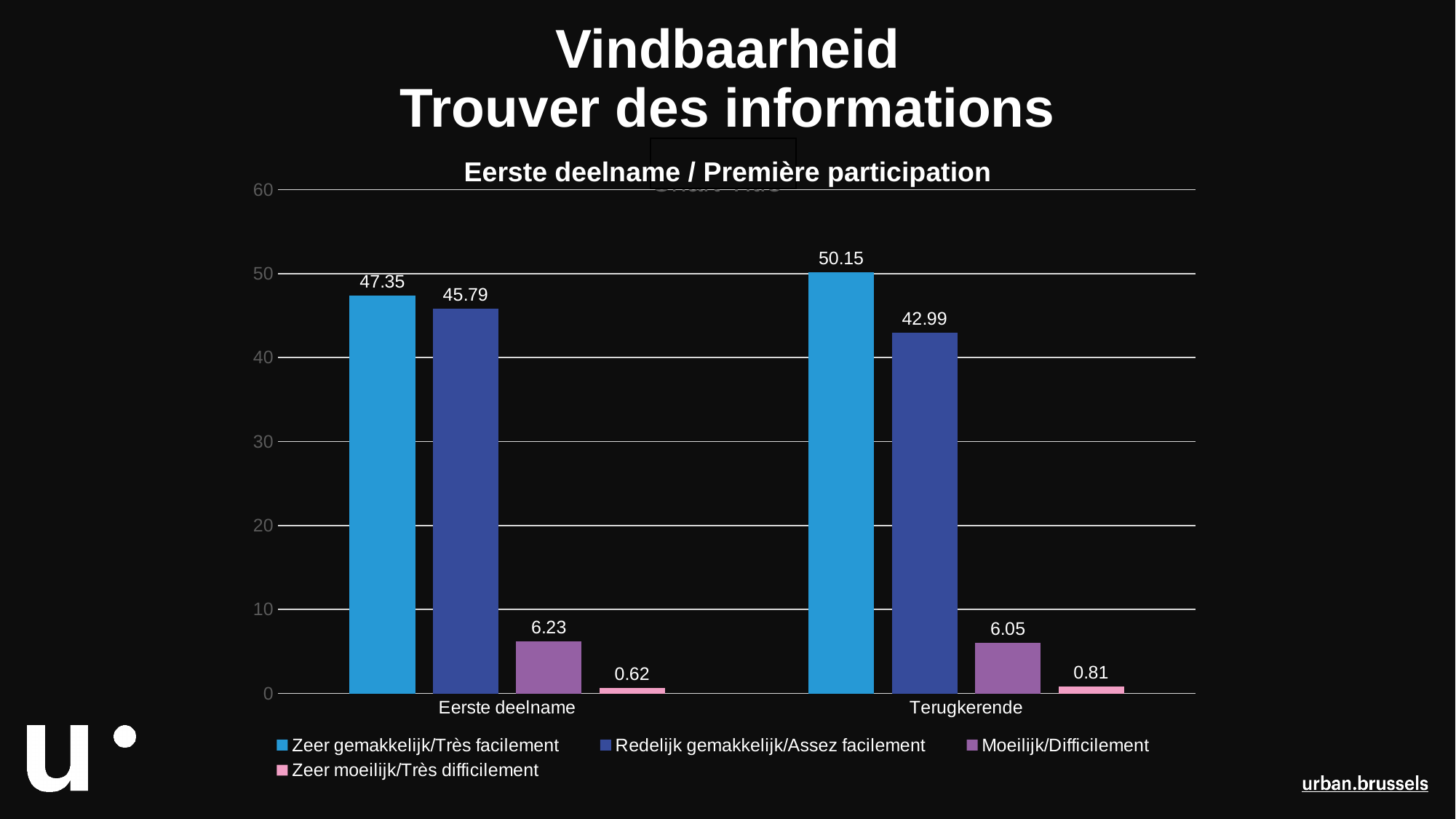
What is the value for Redelijk gemakkelijk/Assez facilement in the Terugkerende category? 42.99 What is the value for Moeilijk/Difficilement in the Eerste deelname category? 6.23 Which series has the highest value in the Terugkerende category? Zeer gemakkelijk/Très facilement What is the value for Zeer moeilijk/Très difficilement in the Terugkerende category? 0.81 What is the value for Zeer gemakkelijk/Très facilement in the Eerste deelname category? 47.35 How many series does the legend list? 4 What kind of chart is shown on the slide? Bar chart How many categories are shown on the x axis? 2 Which series has the lowest value in the Eerste deelname category? Zeer moeilijk/Très difficilement What is the difference between the Zeer gemakkelijk/Très facilement values for Terugkerende and Eerste deelname? 2.8 Which is larger: Redelijk gemakkelijk/Assez facilement for Eerste deelname or for Terugkerende? Eerste deelname Is the value for Zeer gemakkelijk/Très facilement in the Terugkerende category greater or less than 50? greater